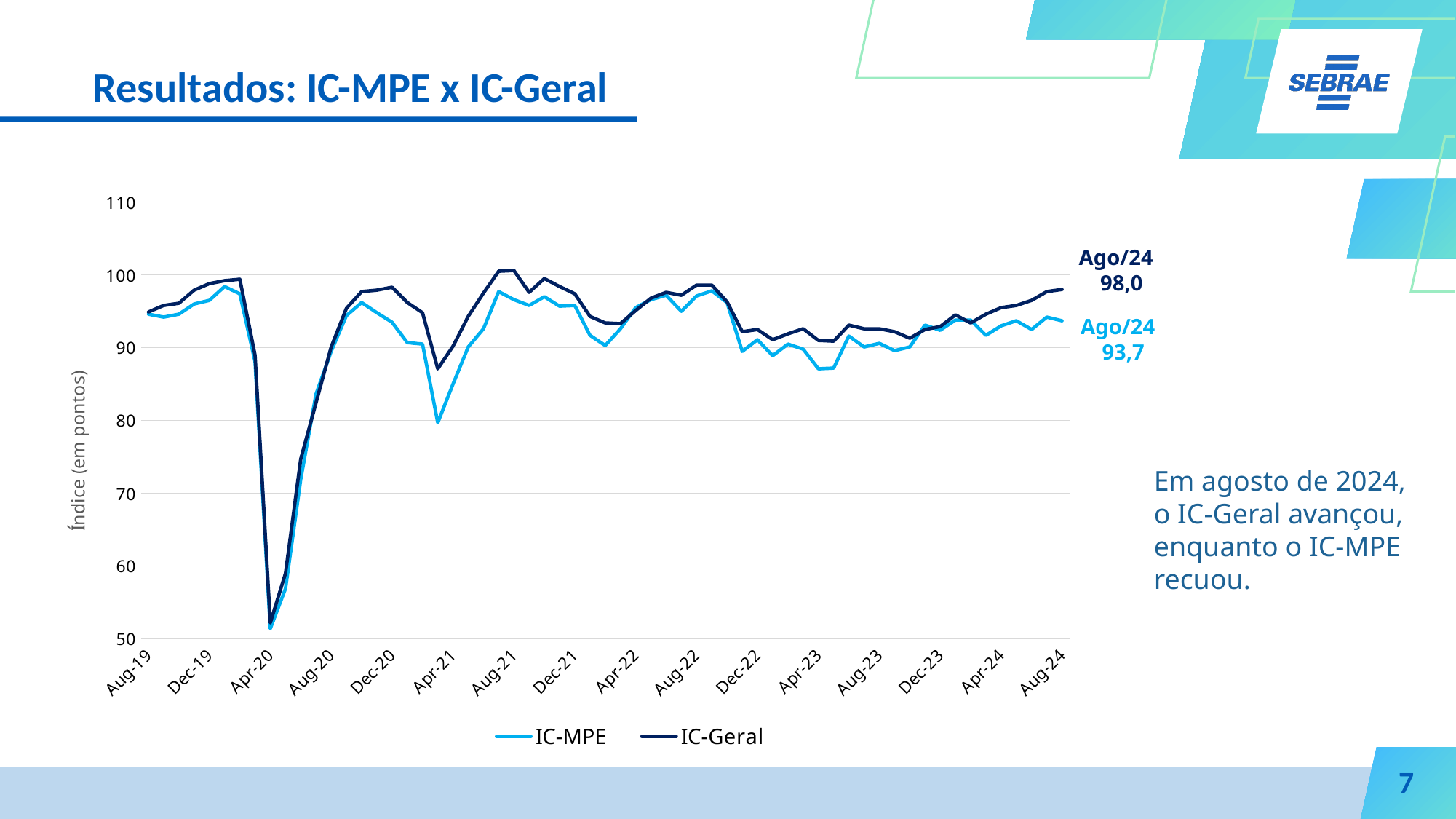
What is the title of the vertical axis? Índice (em pontos) Around which x-axis label do both series reach their lowest point? Apr-20 How many series does the legend list? 2 Is the value of IC-MPE at Apr-21 greater or less than 90? less What is the value of IC-MPE in Ago/24 according to the data label? 93,7 In Ago/24, which series has the higher value, IC-MPE or IC-Geral? IC-Geral What is the difference between the IC-Geral and IC-MPE values labelled for Ago/24? 4,3 Between Apr-20 and Aug-20, do the values of IC-Geral rise or fall? rise Is the value of IC-MPE at Apr-20 greater or less than 60? less What is the value of IC-Geral in Ago/24 according to the data label? 98,0 What kind of chart is shown on the slide? Line chart How many labels are shown on the x axis? 16